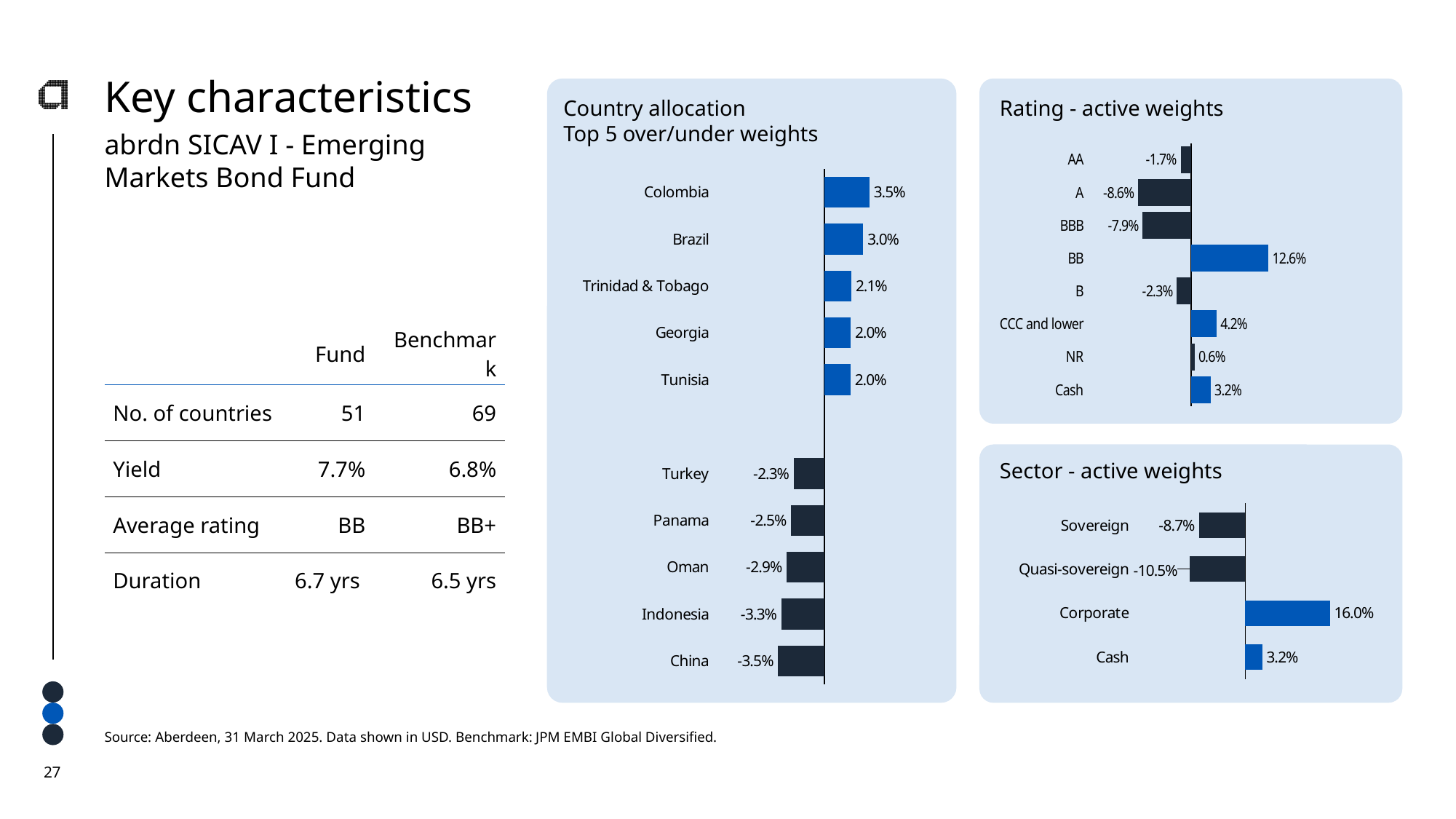
In the Rating - active weights chart, which rating category has the lowest value? A In the Country allocation chart, which country has the lowest value? China In the Country allocation chart, what is the difference between the values for Colombia and Brazil? 0.5% In the Sector - active weights chart, what is the value for Quasi-sovereign? -10.5% In the Sector - active weights chart, which sector has the highest value? Corporate In the Rating - active weights chart, what is the value for BB? 12.6% In the Rating - active weights chart, which is larger, the value for CCC and lower or the value for Cash? CCC and lower What kind of chart is the Sector - active weights chart? Bar chart In the Sector - active weights chart, what is the difference between the values for Corporate and Cash? 12.8% In the Country allocation chart, what is the value for Colombia? 3.5% In the Rating - active weights chart, how many rating categories are shown? 8 In the Country allocation chart, how many countries are shown? 10